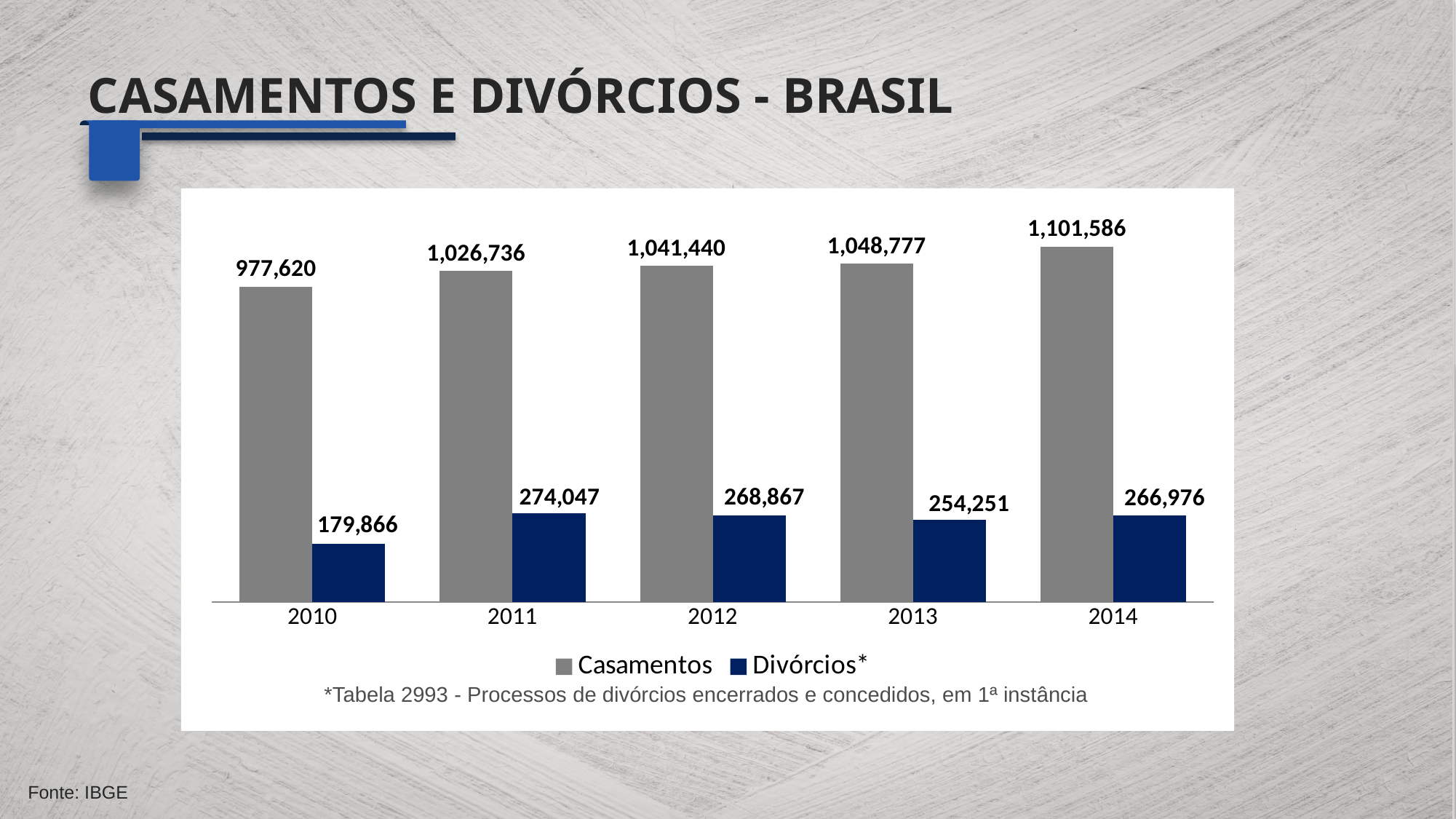
What is the value for Casamentos in 2012? 1,041,440 By how much did Divórcios* increase from 2010 to 2011? 94,181 Do the Casamentos values rise or fall from 2010 to 2014? Rise What is the value for Casamentos in 2014? 1,101,586 Which is larger, Divórcios* in 2012 or Divórcios* in 2013? 2012 How many series does the legend list? 2 How many years are shown on the x axis? 5 In which year is the Divórcios* value highest? 2011 What kind of chart is shown on the slide? Bar chart What is the value for Divórcios* in 2010? 179,866 In which year is the Casamentos value lowest? 2010 What is the difference between Casamentos and Divórcios* in 2014? 834,610